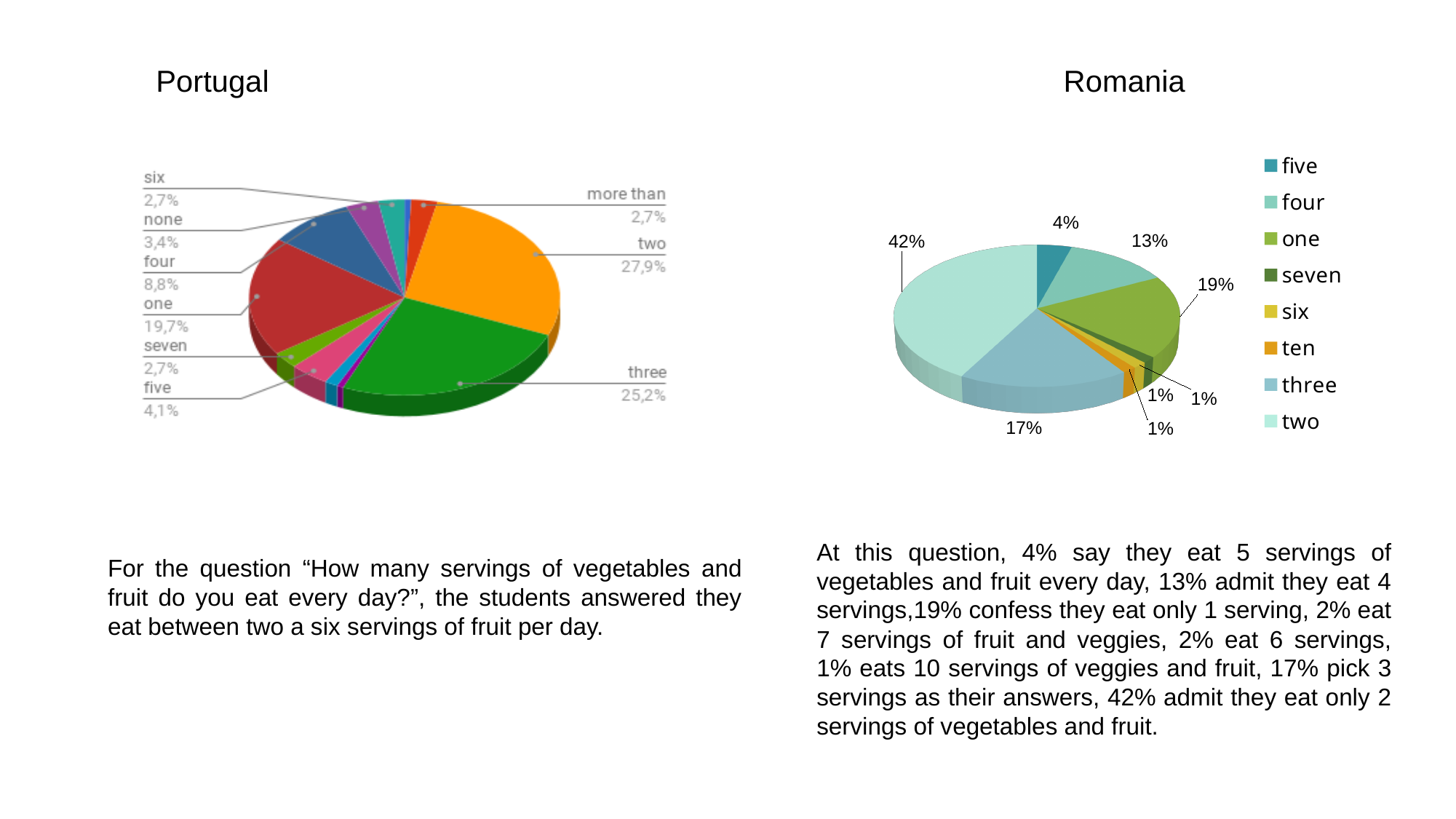
In the Romania chart, what percentage of students answered "two"? 42% In the Portugal chart, which is larger, the share for "four" or the share for "five"? four In the Portugal chart, which answer has the largest share? two In the Romania chart, what percentage of students answered "three"? 17% In the Portugal chart, what percentage of students answered "two"? 27,9% In the Portugal chart, what is the difference between the shares for "two" and "three"? 2,7% In the Portugal chart, how many answer categories are shown? 9 In the Romania chart, which answer has the largest share? two In the Romania chart, what is the difference between the shares for "one" and "four"? 6% In the Portugal chart, what percentage of students answered "one"? 19,7% How many entries does the legend of the Romania chart list? 8 What type of chart is used for Romania? Pie chart